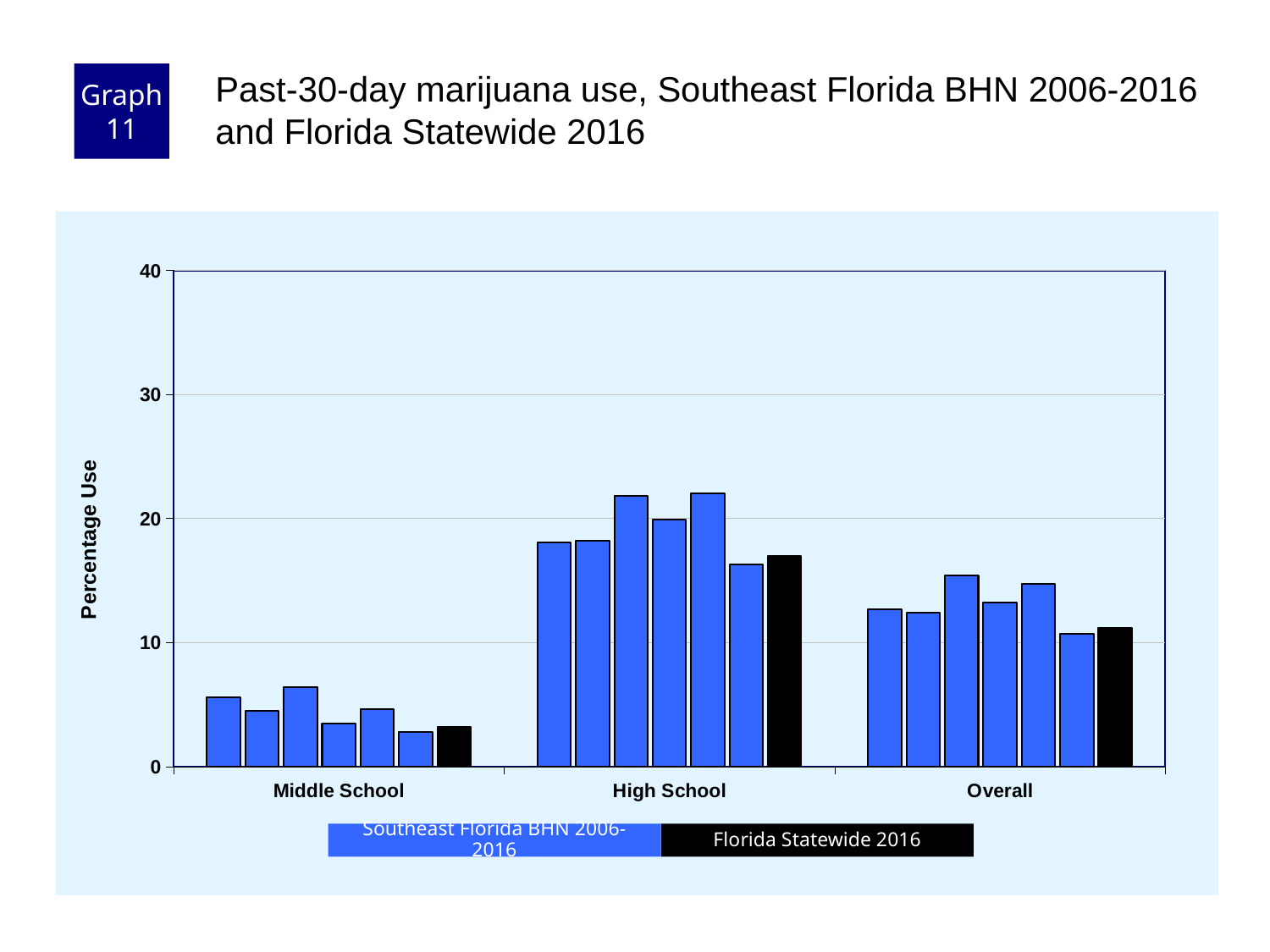
Is the Florida Statewide 2016 value for Middle School greater or less than 10? less How many categories are shown on the x axis? 3 Which category has the highest bars overall? High School Which is larger, the Florida Statewide 2016 value for High School or for Middle School? High School What is the label on the y axis? Percentage Use What kind of chart is shown on the slide? bar chart Is the Florida Statewide 2016 value for Overall greater or less than 20? less What colour are the Florida Statewide 2016 bars? black How many series does the legend list? 2 Is the Florida Statewide 2016 value for High School greater or less than 10? greater Which category has the lowest bars overall? Middle School